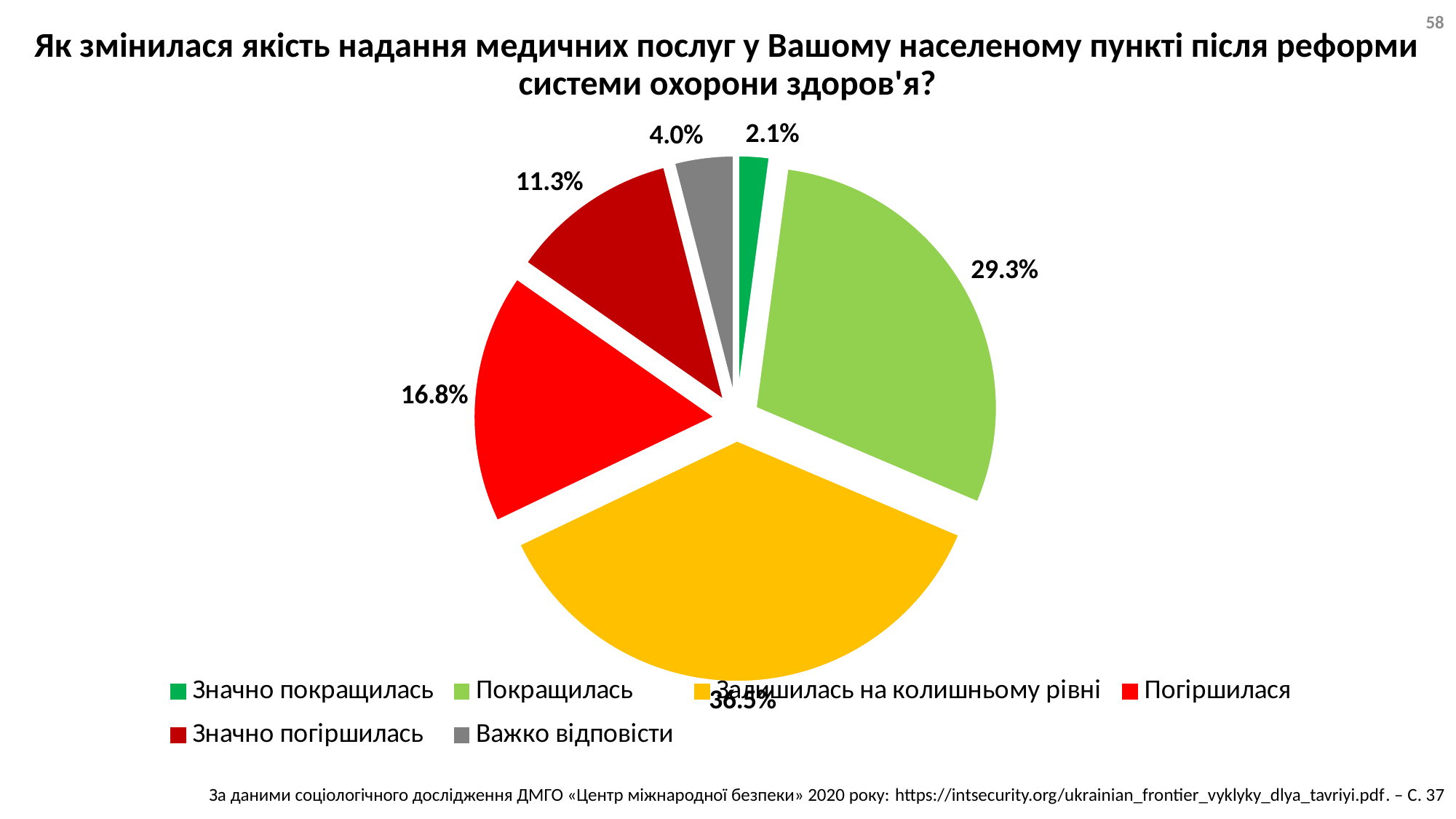
Which answer option has the largest share of the pie? Залишилась на колишньому рівні What is the difference between the shares for "Покращилась" and "Погіршилася"? 12.5% What share of respondents answered "Погіршилася"? 16.8% What share of respondents answered "Значно погіршилась"? 11.3% What share of respondents answered "Значно покращилась"? 2.1% What colour is the slice for "Значно погіршилась"? dark red What share of respondents answered "Важко відповісти"? 4.0% What kind of chart is shown on the slide? pie chart Which is larger: the share for "Значно погіршилась" or the share for "Важко відповісти"? Значно погіршилась How many answer options does the legend list? 6 Which answer option has the smallest share of the pie? Значно покращилась What share of respondents answered "Покращилась"? 29.3%